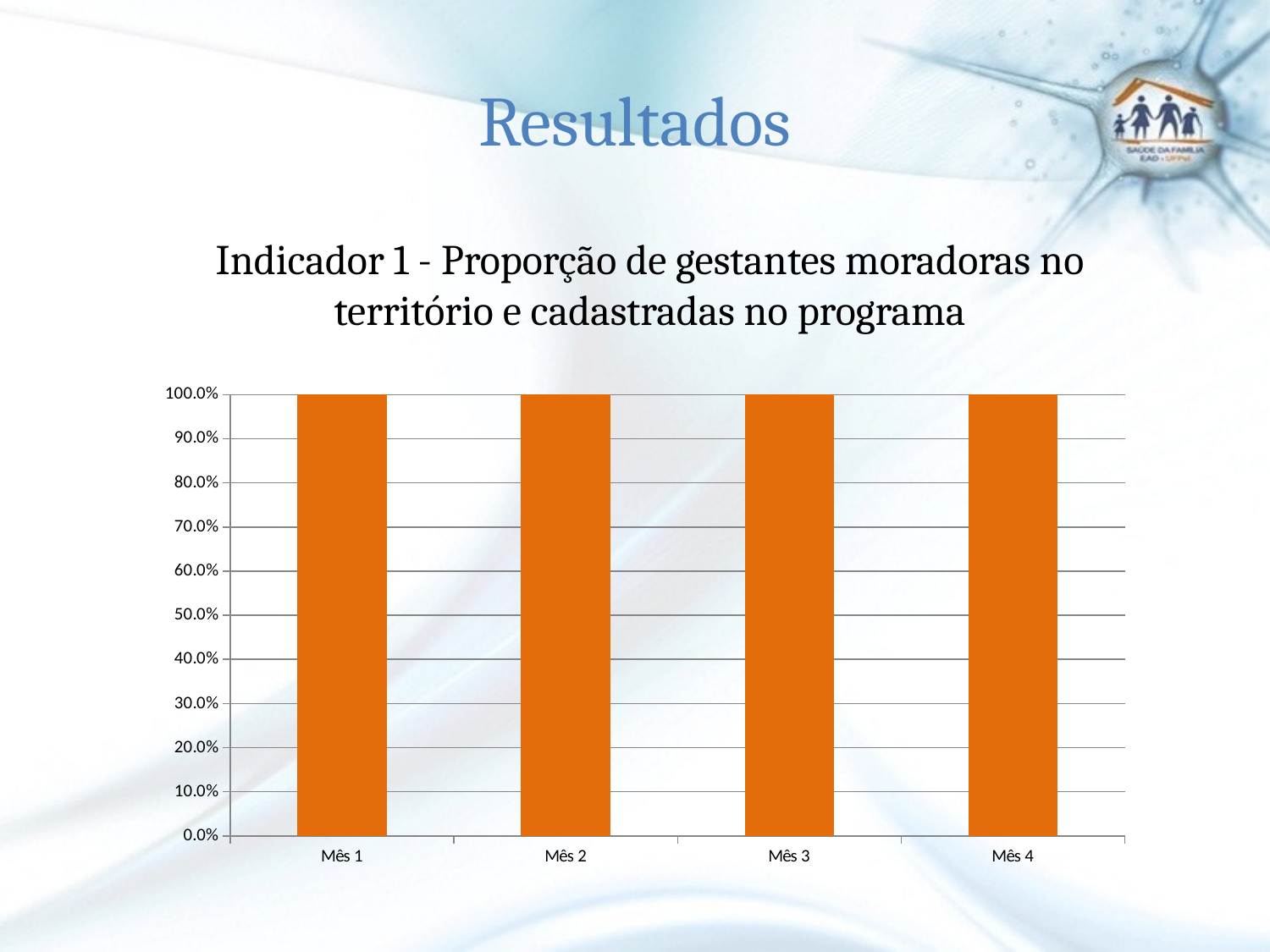
What is the value for Mês 2? 100.0% What colour are the bars in the chart? Orange What kind of chart is shown on the slide? Bar chart What is the difference between the values for Mês 2 and Mês 3? 0.0% What is the title of the chart? Indicador 1 - Proporção de gestantes moradoras no território e cadastradas no programa How many months (categories) are shown on the x axis? 4 What is the value for Mês 4? 100.0% What is the value for Mês 1? 100.0% What is the value for Mês 3? 100.0% Do the values rise, fall, or stay the same from Mês 1 to Mês 4? Stay the same Is the value for Mês 1 larger than, smaller than, or equal to the value for Mês 4? Equal Is the value for Mês 3 greater or less than 50.0%? greater